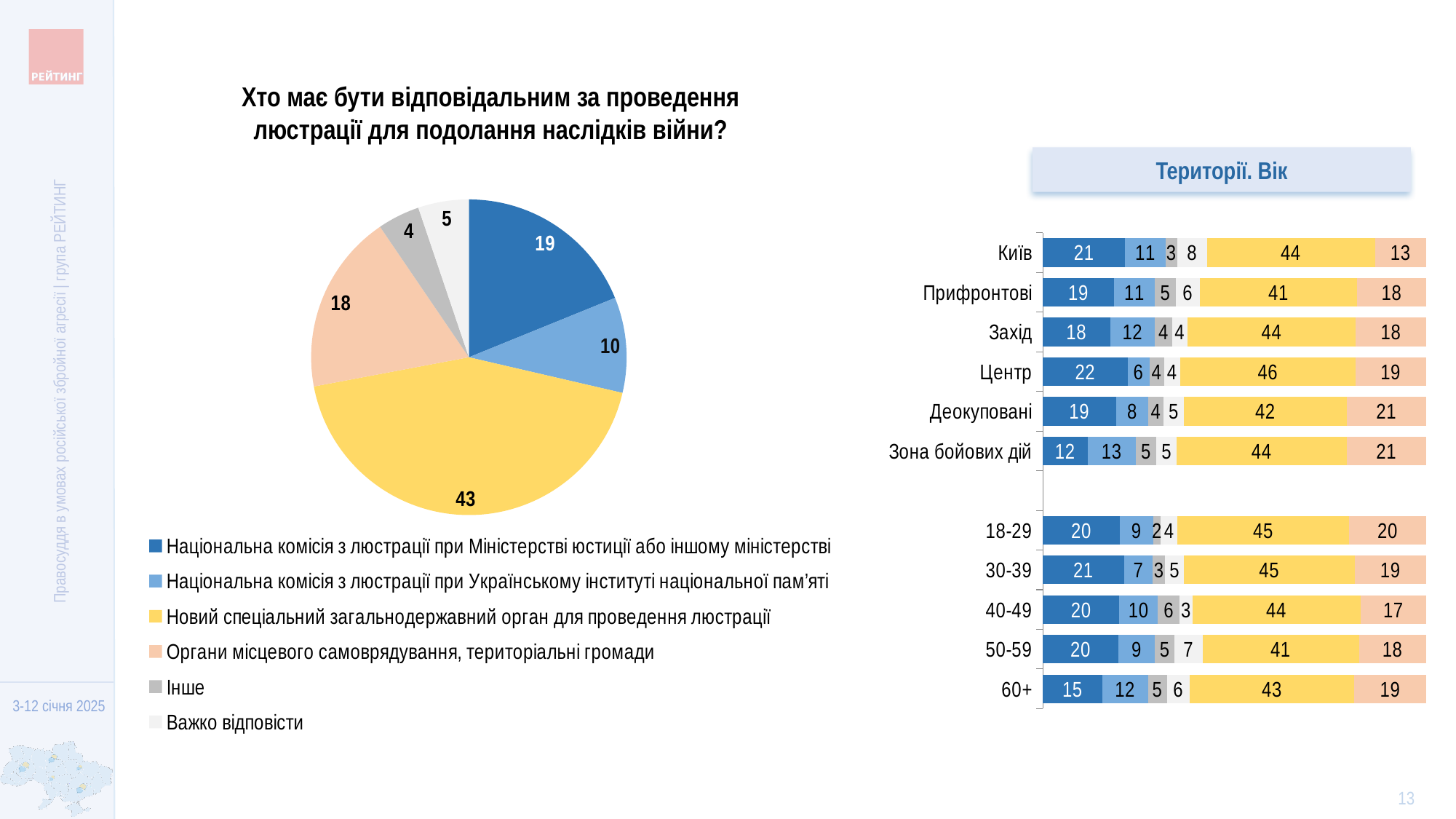
In the 'Території. Вік' bar chart, which has the larger dark blue value: 'Центр' or 'Зона бойових дій'? Центр In the pie chart, which category has the largest slice? Новий спеціальний загальнодержавний орган для проведення люстрації In the pie chart, what value is shown for 'Новий спеціальний загальнодержавний орган для проведення люстрації'? 43 How many category rows are shown in the 'Території. Вік' bar chart? 11 In the 'Території. Вік' bar chart, what is the value for 'Національна комісія з люстрації при Міністерстві юстиції' (dark blue) in the '60+' row? 15 What kind of chart is the 'Території. Вік' chart on the right? Stacked bar chart In the 'Території. Вік' bar chart, which row has the highest yellow ('Новий спеціальний загальнодержавний орган') value? Центр In the 'Території. Вік' bar chart, what is the value for 'Новий спеціальний загальнодержавний орган' (yellow) in the 'Центр' row? 46 In the 'Території. Вік' bar chart, what is the difference between the 'Органи місцевого самоврядування' values for 'Зона бойових дій' and 'Київ'? 8 How many entries does the legend of the pie chart list? 6 What kind of chart is the chart on the left of the slide? Pie chart In the pie chart, which category has the smallest slice? Інше